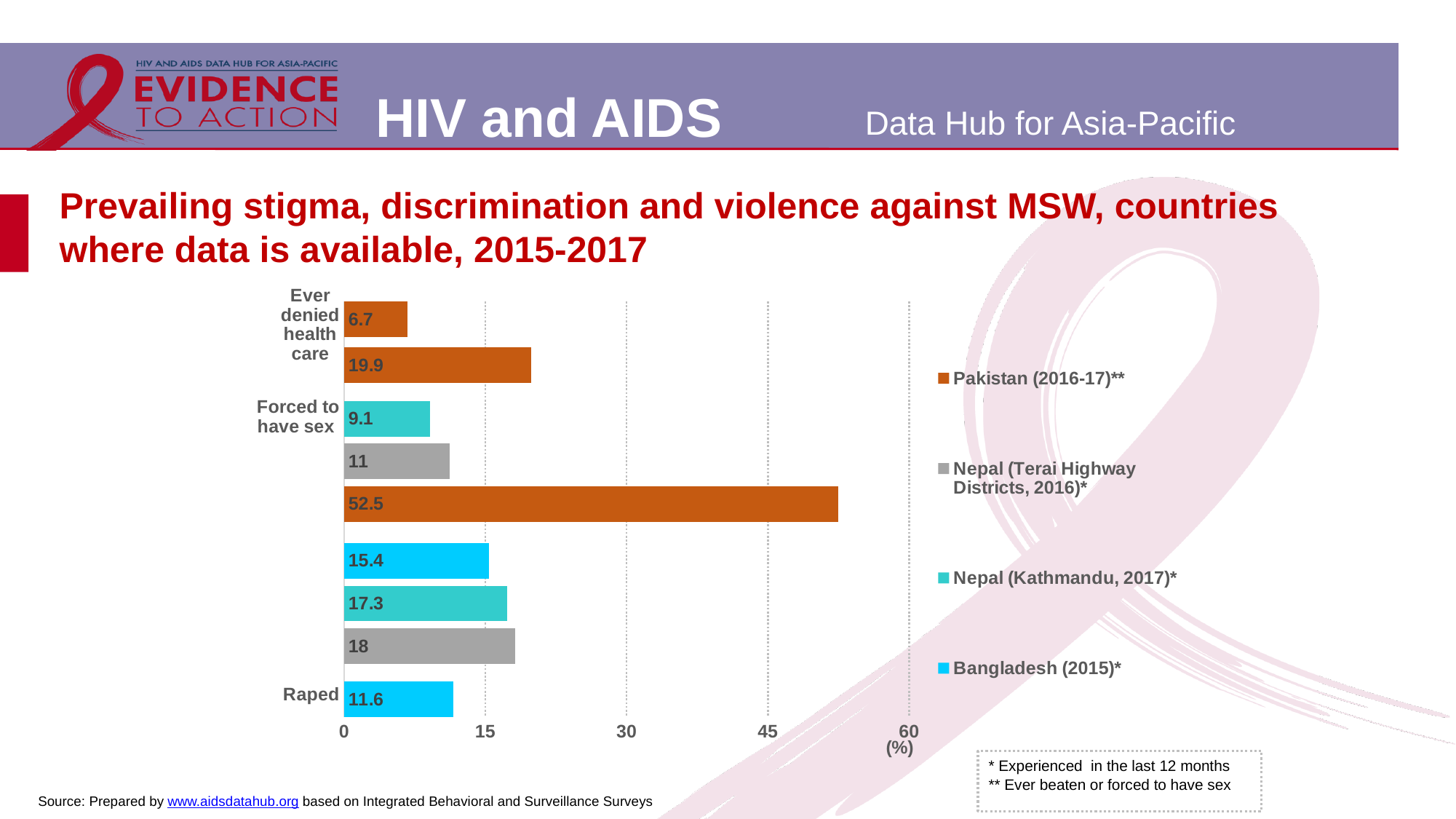
How many series does the legend list? 4 What is the value of the Bangladesh (2015) bar next to the 'Raped' label? 11.6 What is the maximum value shown on the horizontal axis? 60 What is the smallest value shown on any bar in the chart? 6.7 What is the difference between the two Pakistan bars labelled 19.9 and 6.7 under 'Ever denied health care'? 13.2 Which is larger, the Pakistan bar labelled 52.5 or the Pakistan bar labelled 19.9? 52.5 Which legend entry is shown in orange? Pakistan (2016-17)** Is the longest Pakistan (2016-17) bar greater or less than 45? greater How many bars are plotted in the chart? 9 What kind of chart is shown on the slide? bar chart What is the value of the Nepal (Kathmandu, 2017) bar next to the 'Forced to have sex' label? 9.1 What is the largest value shown on any bar in the chart? 52.5